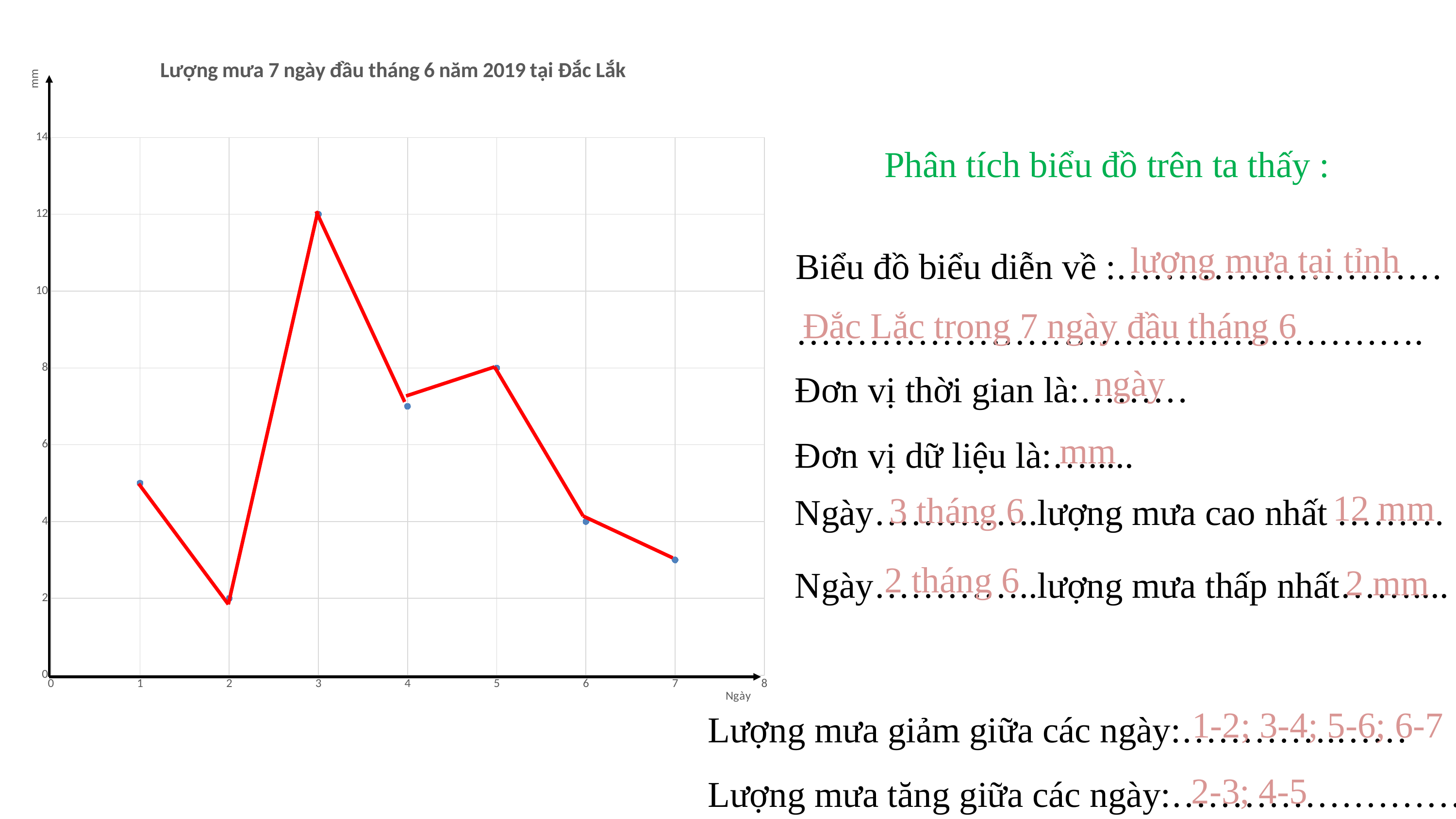
What is the rainfall value for day 3? 12 What is the rainfall value for day 2? 2 Is the value for day 7 greater or less than 4? less Which day has the lowest rainfall? 2 How many days are plotted on the chart? 7 What is the rainfall value for day 6? 4 What kind of chart is shown on the slide? line chart Which day has more rainfall, day 5 or day 6? 5 Is the value for day 4 greater or less than 6? greater Which day has the highest rainfall? 3 What is the difference between the rainfall on day 3 and day 2? 10 What is the rainfall value for day 5? 8